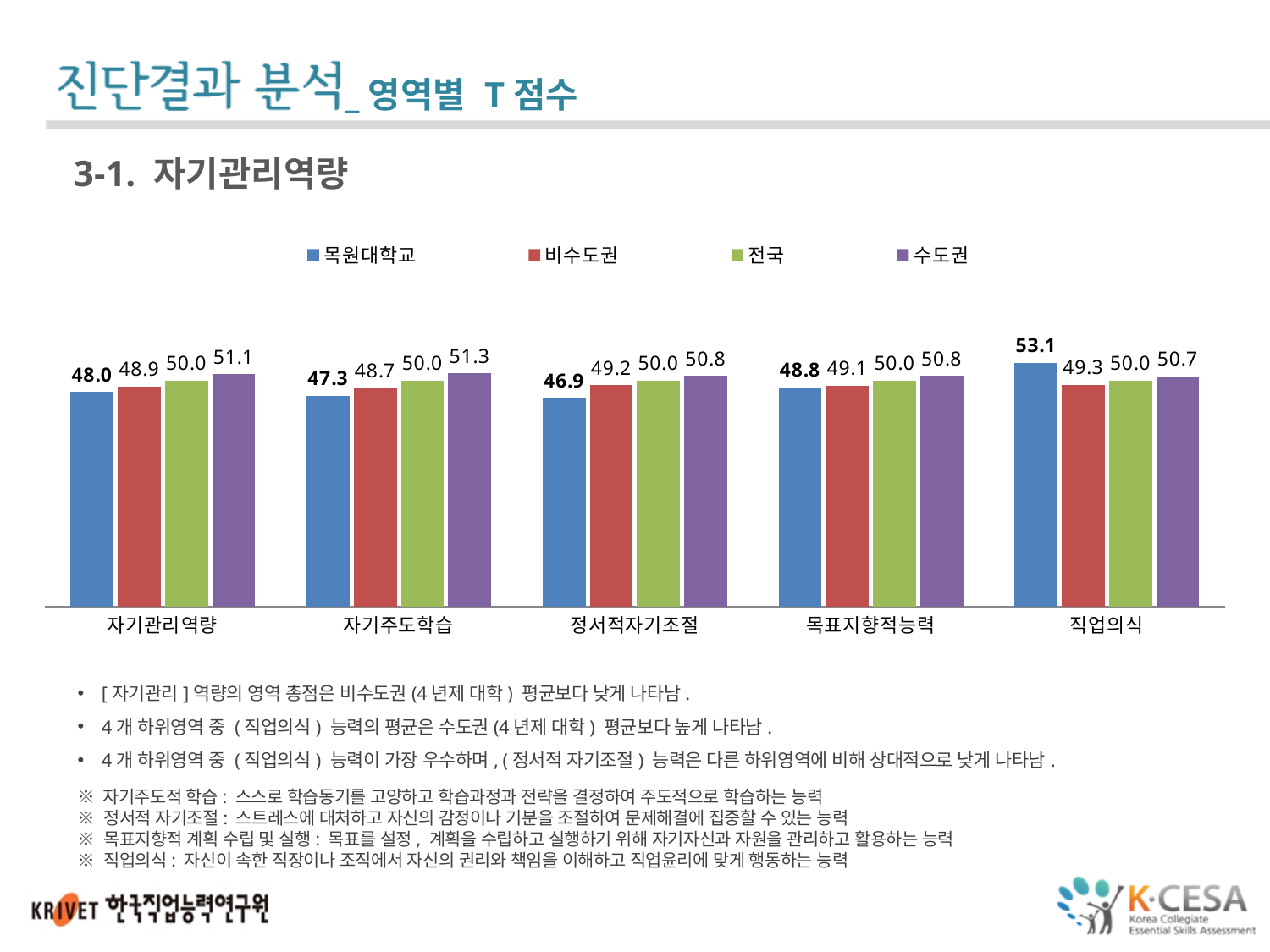
What kind of chart is shown on the slide? bar chart How many series does the legend list? 4 What is the value for 비수도권 in the 정서적자기조절 category? 49.2 What is the value for 수도권 in the 자기주도학습 category? 51.3 In which category does 목원대학교 have its highest value? 직업의식 In the 직업의식 category, which is larger: the 목원대학교 value or the 수도권 value? 목원대학교 How many categories are shown on the x axis of the chart? 5 What is the difference between the 수도권 and 목원대학교 values in the 자기관리역량 category? 3.1 In which category does 목원대학교 have its lowest value? 정서적자기조절 What is the value for 전국 in every category? 50.0 Which series is shown in purple in the legend? 수도권 What is the value for 목원대학교 in the 직업의식 category? 53.1